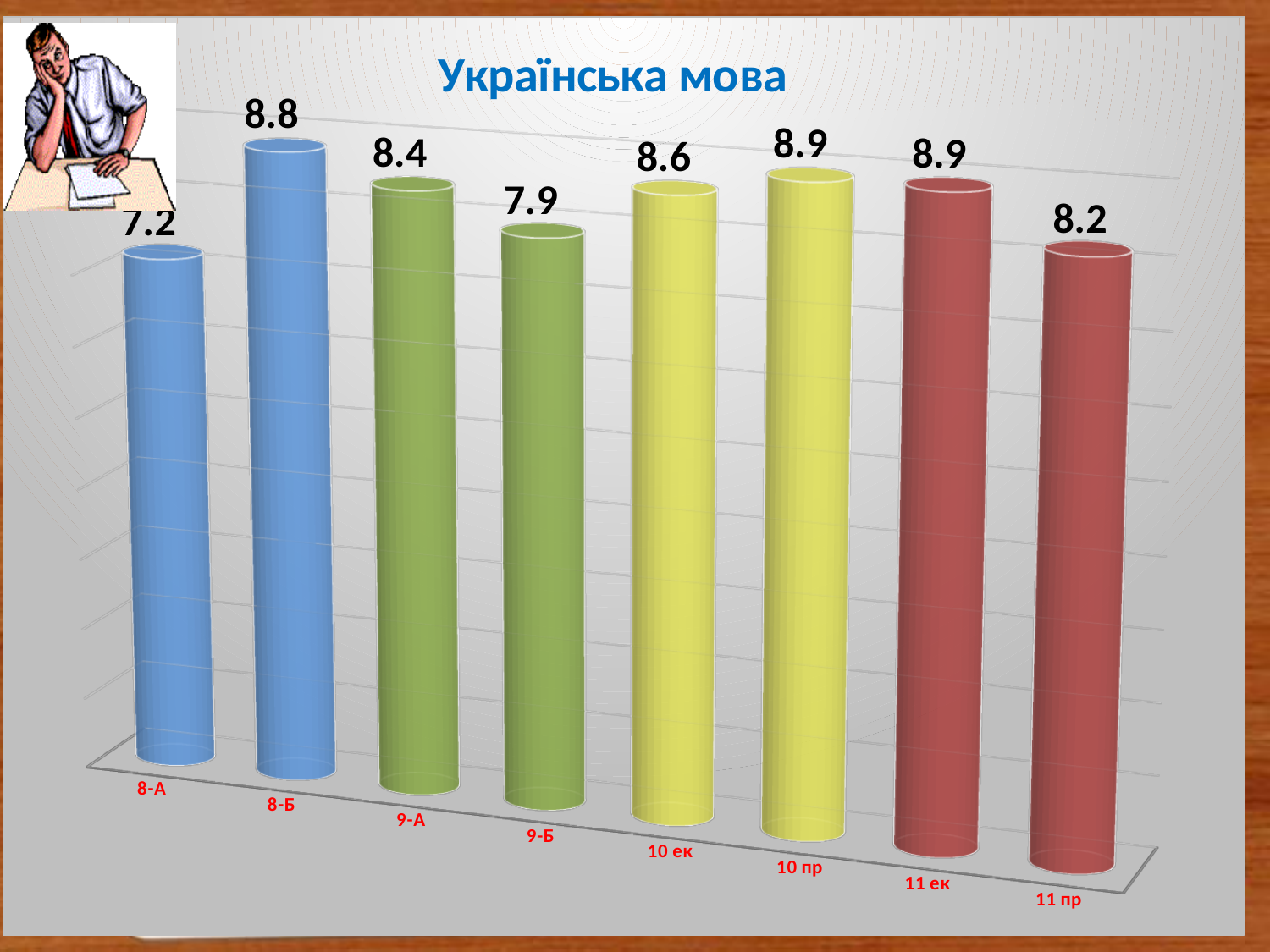
Which category has the lowest value? 8-А Which has a larger value, 10 ек or 10 пр? 10 пр What is the value for 9-Б? 7.9 What is the difference between the values for 9-А and 9-Б? 0.5 Which has a larger value, 11 пр or 9-А? 9-А How many categories are shown in the chart? 8 What is the difference between the values for 8-Б and 8-А? 1.6 What is the value for 10 ек? 8.6 What is the value for 11 пр? 8.2 What is the value for 8-А? 7.2 What kind of chart is this? bar chart What is the title of the chart? Українська мова